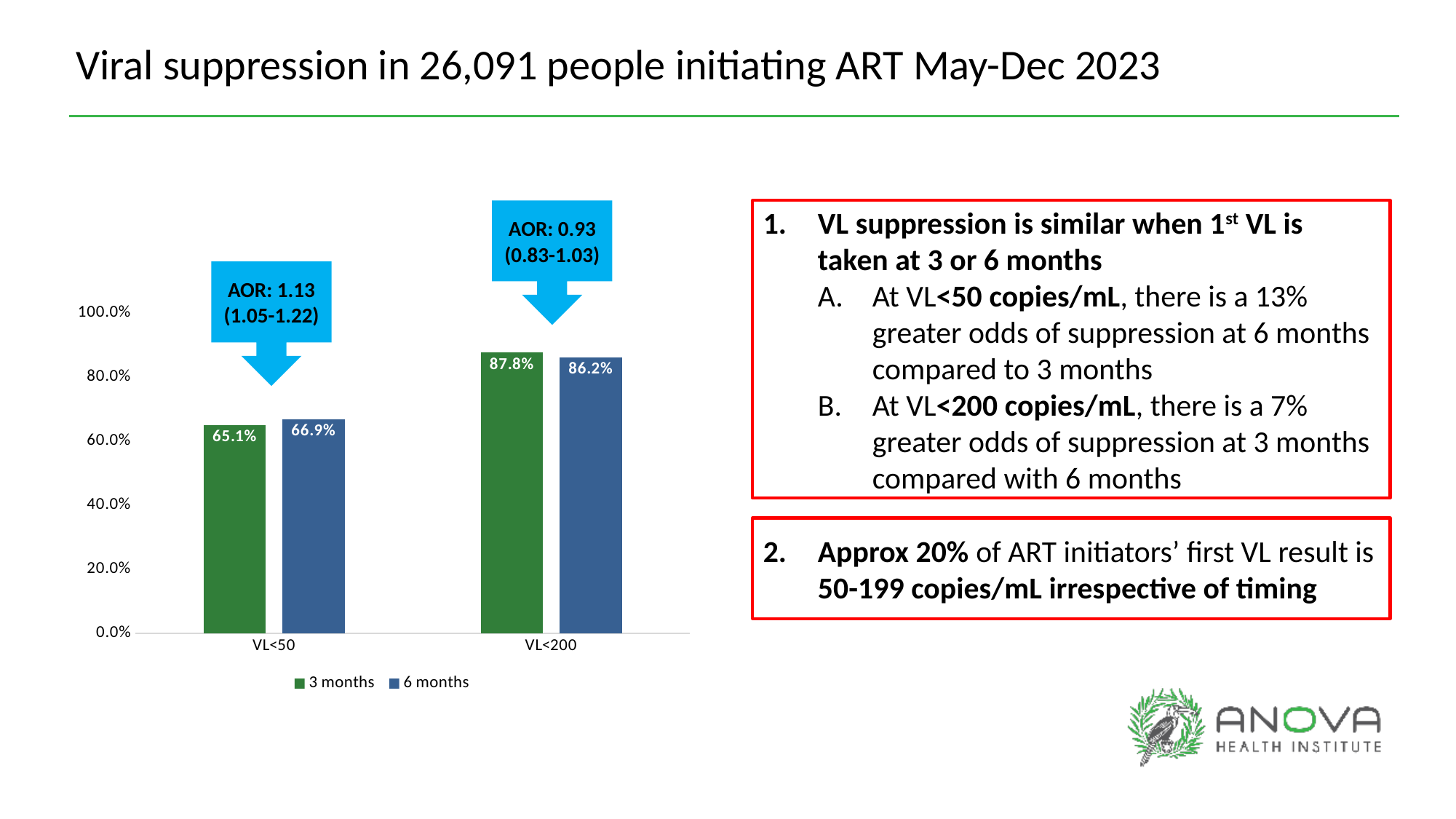
What kind of chart is shown on the slide? Bar chart What is the value for 3 months at VL<50? 65.1% Which bar has the lowest value on the chart? 3 months at VL<50 What is the value for 6 months at VL<200? 86.2% How many series does the legend list? 2 What is the value for 6 months at VL<50? 66.9% How many categories are shown on the x axis? 2 What is the value for 3 months at VL<200? 87.8% What is the difference between the 6 months and 3 months values at VL<50? 1.8% Which bar has the highest value on the chart? 3 months at VL<200 What is the difference between the 3 months and 6 months values at VL<200? 1.6% Which colour represents the 6 months series? Blue